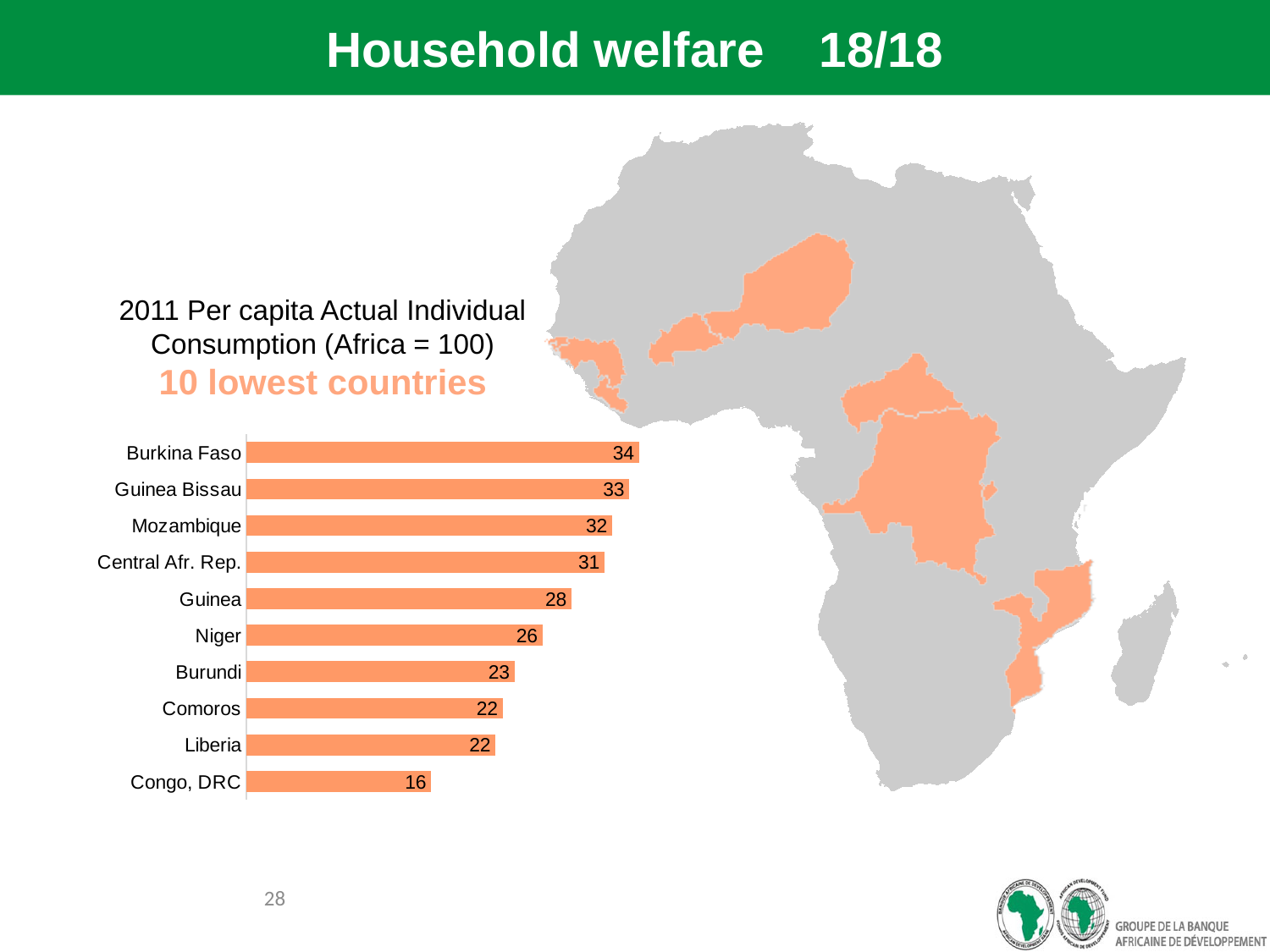
What is the difference between the values for Burkina Faso and Congo, DRC? 18 Which country has the lowest value in the chart? Congo, DRC What is the value for Niger? 26 What is the difference between the values for Mozambique and Burundi? 9 How many countries are shown in the bar chart? 10 Which country has the highest value in the chart? Burkina Faso What is the value for Congo, DRC? 16 What kind of chart is shown on the slide? Bar chart What is the value for Central Afr. Rep.? 31 What is the title of the chart? 2011 Per capita Actual Individual Consumption (Africa = 100) 10 lowest countries Which has a larger value, Guinea or Comoros? Guinea What is the value for Burkina Faso? 34